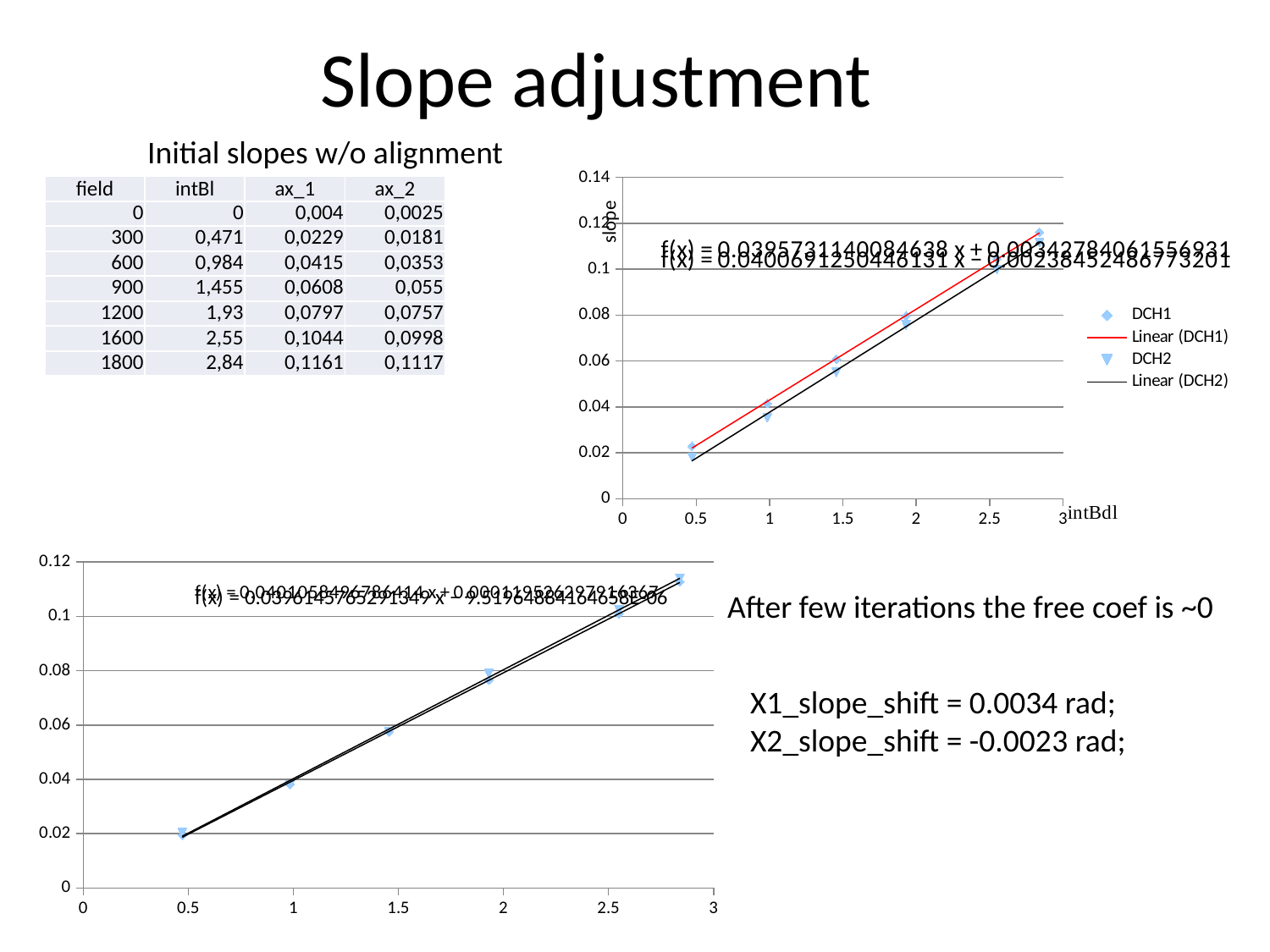
What kind of chart is the bottom-left chart on the slide? scatter chart In the top-right chart, what colour is the Linear (DCH1) trendline? red In the top-right chart, do the DCH1 values rise or fall as intBdl increases? rise In the top-right chart, is the DCH2 value at intBdl about 1.5 greater or less than 0.06? less In the top-right chart, what is the label on the vertical axis? slope In the top-right chart, is the DCH1 value at the rightmost point (intBdl about 2.8) greater or less than 0.1? greater In the top-right chart, at intBdl about 1, which series has the higher value, DCH1 or DCH2? DCH1 How many entries does the legend of the top-right chart list? 4 What kind of chart is the top-right chart on the slide? scatter chart In the bottom-left chart, do the plotted values rise or fall along the x axis? rise In the bottom-left chart, is the value at the rightmost point (x about 2.85) greater or less than 0.1? greater